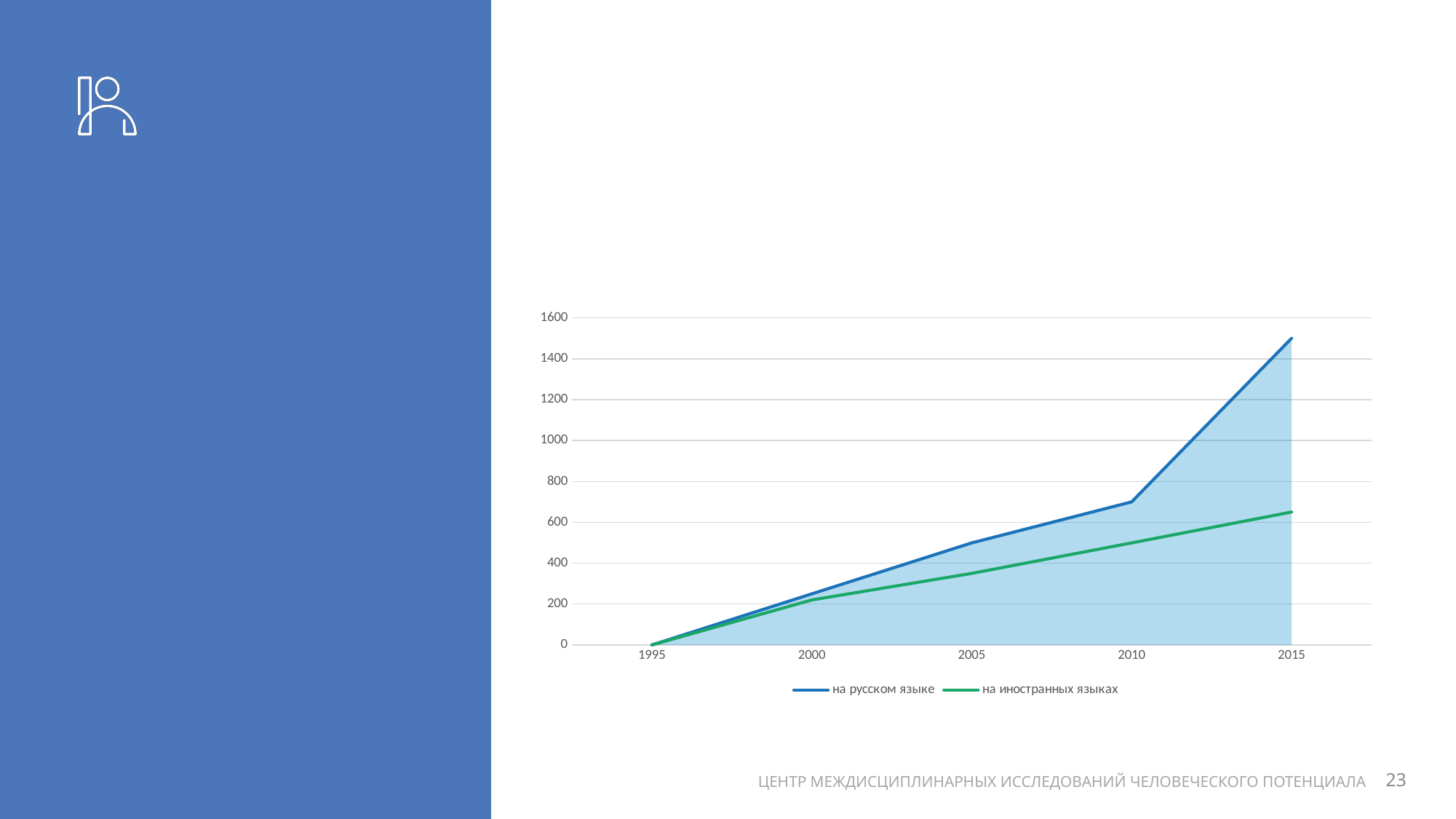
How many series does the legend list? 2 Is the value for 'на русском языке' in 2010 greater or less than 600? greater In which year is the value for 'на иностранных языках' lowest? 1995 Is the value for 'на русском языке' in 2015 greater or less than 1400? greater Is the value for 'на иностранных языках' in 2005 greater or less than 400? less What kind of chart is shown on the slide? combination area and line chart Does the value for 'на русском языке' rise or fall from 1995 to 2015? rise What colour is the line for 'на иностранных языках'? green In 2015, which series has the higher value? на русском языке In which year does 'на русском языке' reach its highest value? 2015 How many years are marked on the x axis? 5